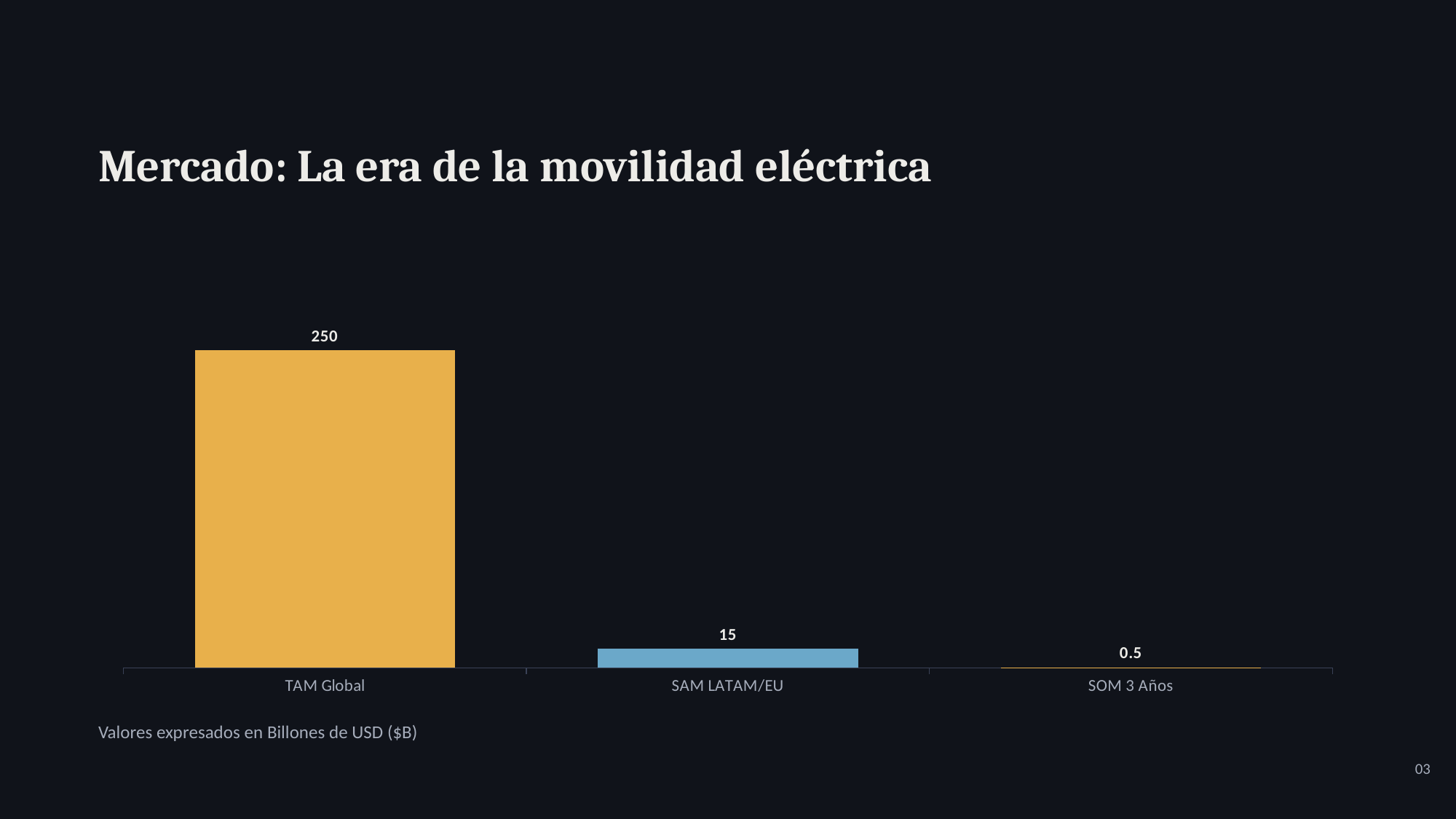
How many categories are shown in the chart? 3 What is the difference between the values for SAM LATAM/EU and SOM 3 Años? 14.5 What kind of chart is shown on the slide? Bar chart What is the value for TAM Global? 250 Which category has the lowest value? SOM 3 Años Which is larger, the value for SAM LATAM/EU or the value for SOM 3 Años? SAM LATAM/EU In what unit are the chart values expressed, according to the note below the chart? Billones de USD ($B) What is the difference between the values for TAM Global and SAM LATAM/EU? 235 What is the value for SAM LATAM/EU? 15 Which category has the highest value? TAM Global What is the value for SOM 3 Años? 0.5 Do the values rise or fall from left to right across the categories? Fall